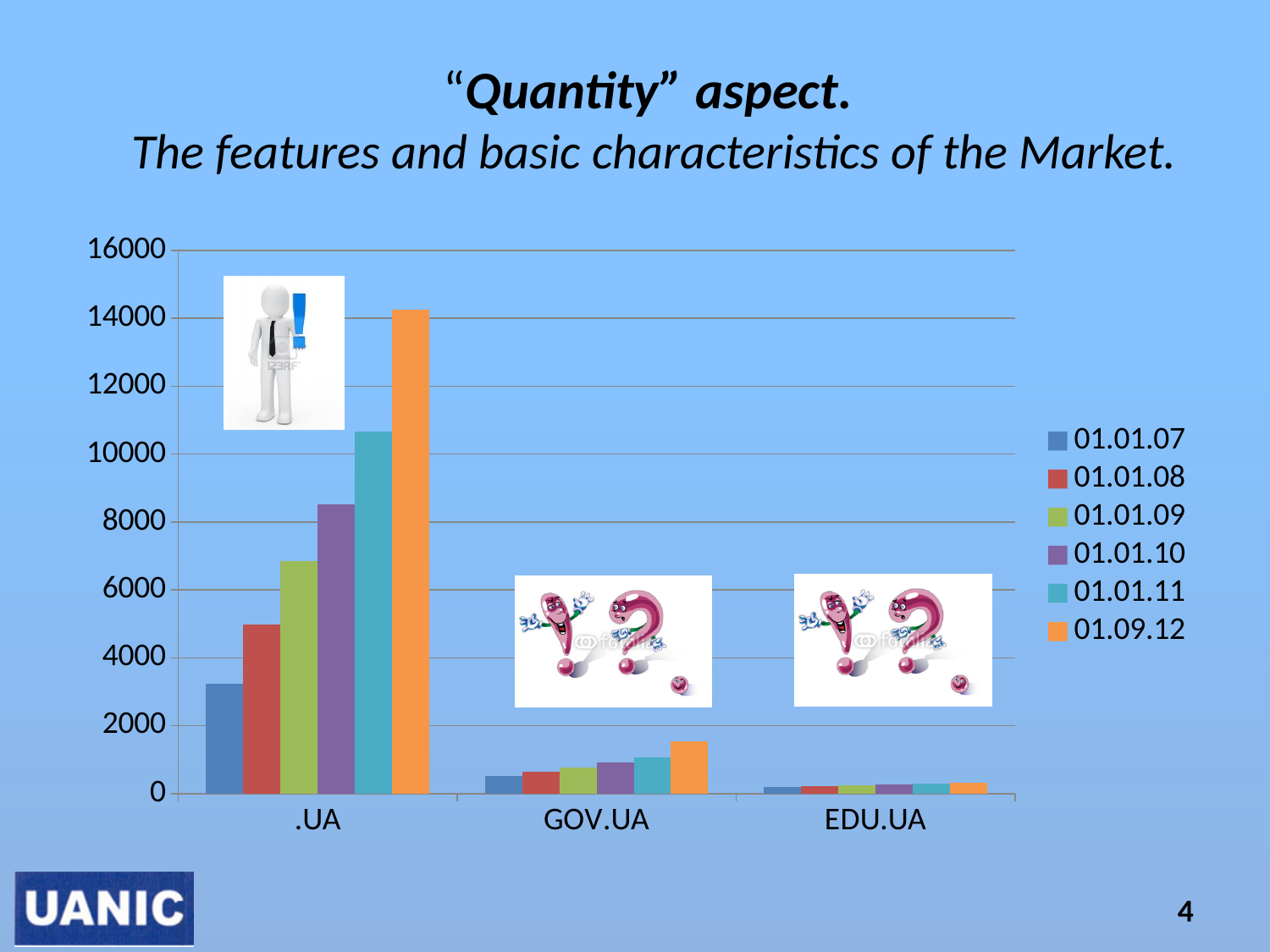
Which legend entry is shown in orange? 01.09.12 Do the values for .UA rise or fall from the 01.01.07 series to the 01.09.12 series? rise Which is larger: the 01.01.07 value for .UA or the 01.09.12 value for GOV.UA? .UA 01.01.07 Is the value for GOV.UA in the 01.09.12 series greater or less than 2000? less How many series does the chart's legend list? 6 How many categories are shown on the x axis of the chart? 3 Is the value for .UA in the 01.09.12 series greater or less than 12000? greater Which category has the lowest values in the chart? EDU.UA What kind of chart is shown on the slide? bar chart Which category has the highest values in the chart? .UA Is the value for .UA in the 01.01.11 series greater or less than 10000? greater